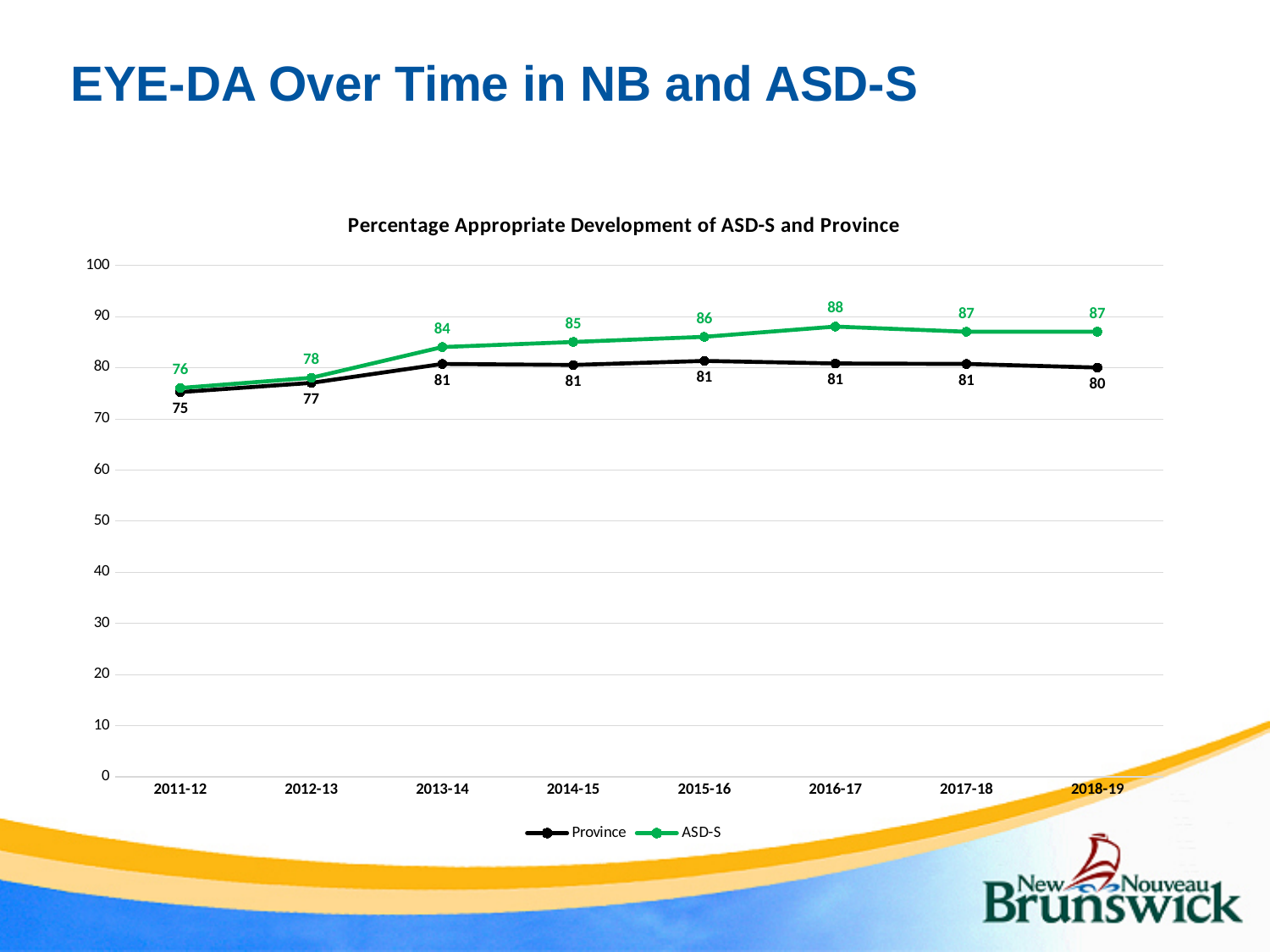
How many years are shown on the x axis? 8 What is the title of the chart? Percentage Appropriate Development of ASD-S and Province Is the ASD-S value for 2018-19 greater or less than 80? greater In which year is the ASD-S series at its highest? 2016-17 What is the Province value for 2018-19? 80 What kind of chart is shown? line chart What is the difference between the ASD-S and Province values in 2016-17? 7 What is the ASD-S value for 2016-17? 88 What is the Province value for 2011-12? 75 In which year is the Province series at its lowest? 2011-12 Which series has the higher value in 2013-14, Province or ASD-S? ASD-S How many series does the legend list? 2